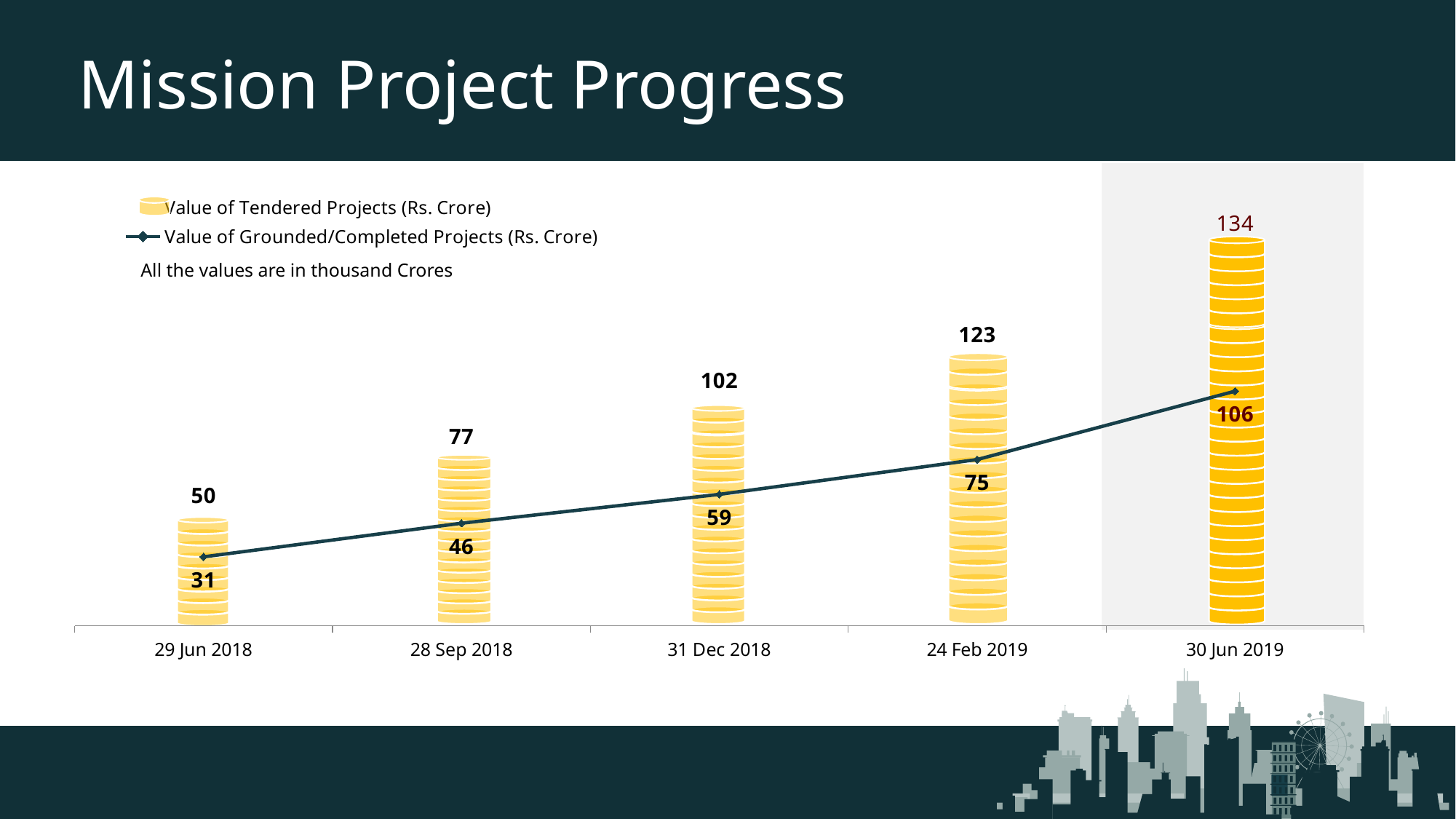
What is the difference between the Value of Tendered Projects and the Value of Grounded/Completed Projects on 30 Jun 2019? 28 What is the title of the slide containing the chart? Mission Project Progress By how much did the Value of Tendered Projects increase from 29 Jun 2018 to 28 Sep 2018? 27 On which date is the Value of Tendered Projects highest? 30 Jun 2019 Does the Value of Grounded/Completed Projects rise or fall over the dates shown? rise What is the Value of Grounded/Completed Projects on 24 Feb 2019? 75 Which is larger on 28 Sep 2018: the Value of Tendered Projects or the Value of Grounded/Completed Projects? Value of Tendered Projects What is the Value of Grounded/Completed Projects on 29 Jun 2018? 31 How many dates are shown on the x axis? 5 On which date is the Value of Grounded/Completed Projects lowest? 29 Jun 2018 How many series does the legend list? 2 What is the Value of Tendered Projects on 31 Dec 2018? 102